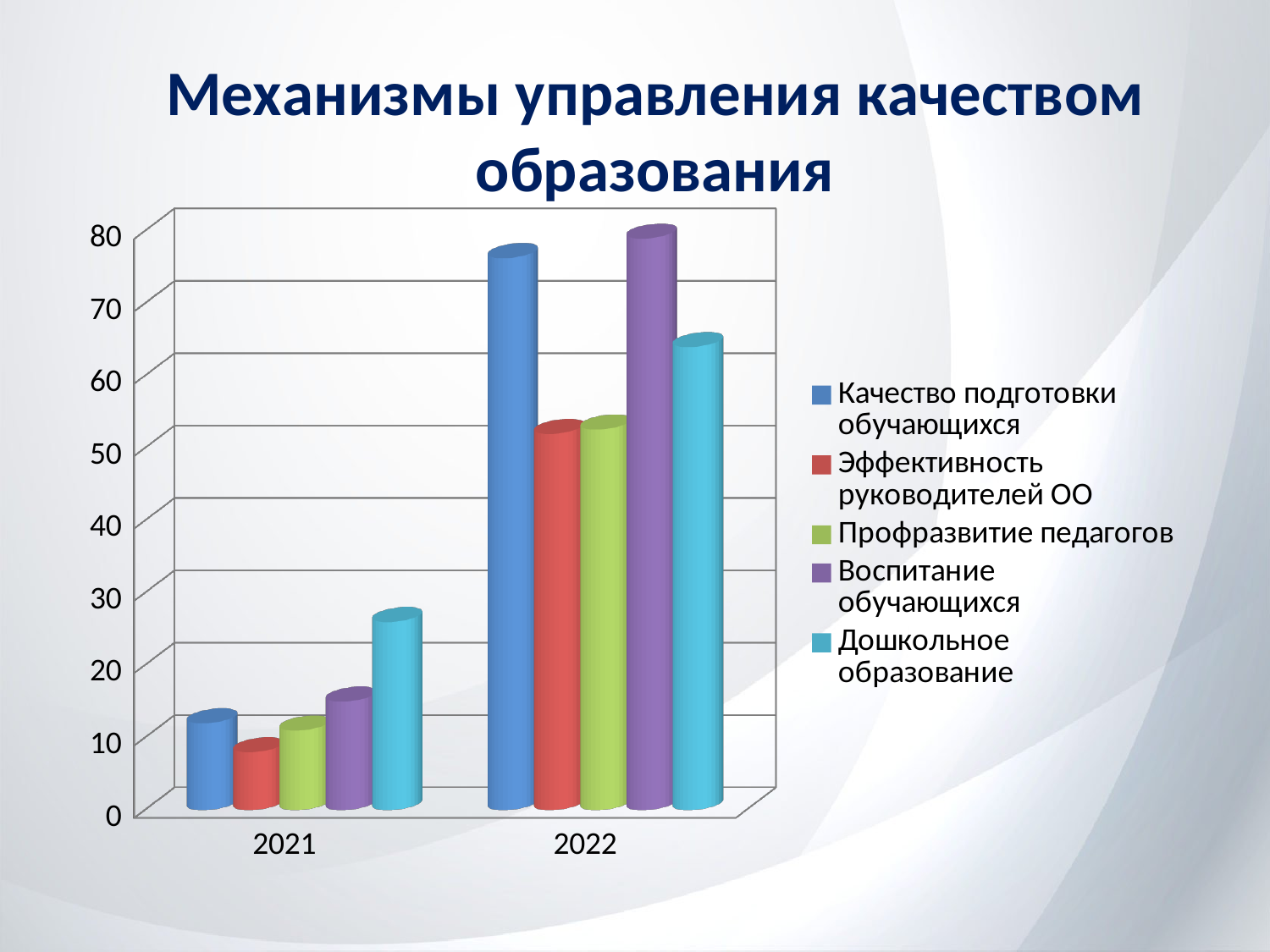
Which series has the lowest value in 2021? Эффективность руководителей ОО Which series has the highest value in 2021? Дошкольное образование In 2021, which is larger: Дошкольное образование or Качество подготовки обучающихся? Дошкольное образование How many categories (years) are shown on the x axis? 2 Is the value for Качество подготовки обучающихся in 2022 greater or less than 70? greater Is the value for Дошкольное образование in 2021 greater or less than 20? greater What kind of chart is shown on the slide? bar chart Does the value for Качество подготовки обучающихся rise or fall from 2021 to 2022? rise What is the title of the slide? Механизмы управления качеством образования Is the value for Дошкольное образование in 2022 greater or less than 60? greater How many series does the legend list? 5